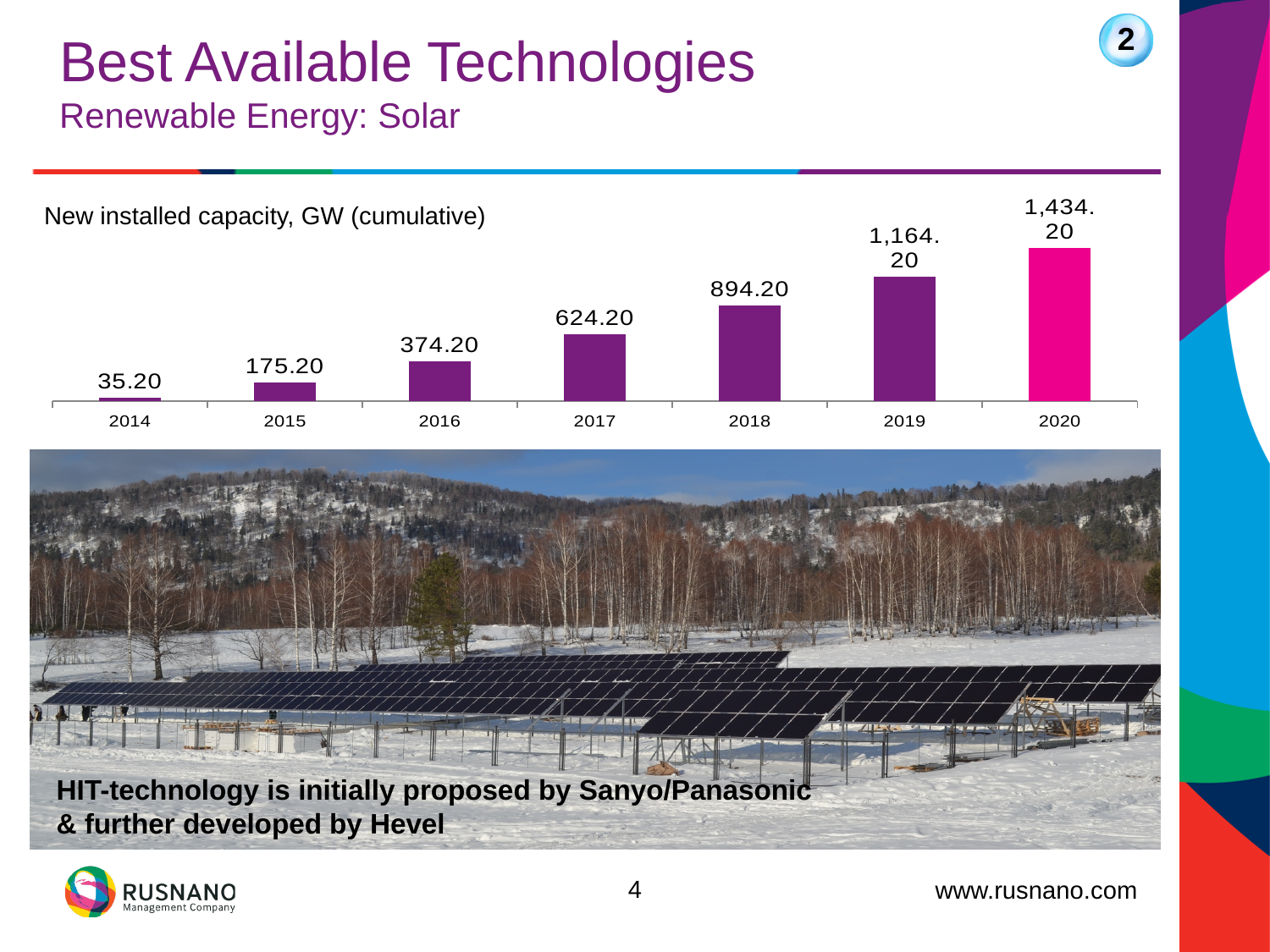
What is the value for 2014 in the chart? 35.20 Which is larger, the value for 2018 or the value for 2016? 2018 How many years are shown on the x axis of the chart? 7 Which year has the lowest value in the chart? 2014 What is the value for 2020 in the chart? 1,434.20 Which year has the highest value in the chart? 2020 What kind of chart is shown on the slide? Bar chart Do the values rise or fall from 2014 to 2020? Rise What is the difference between the values for 2020 and 2019? 270.00 What is the value for 2017 in the chart? 624.20 What is the difference between the values for 2016 and 2015? 199.00 What is the title of the chart? New installed capacity, GW (cumulative)